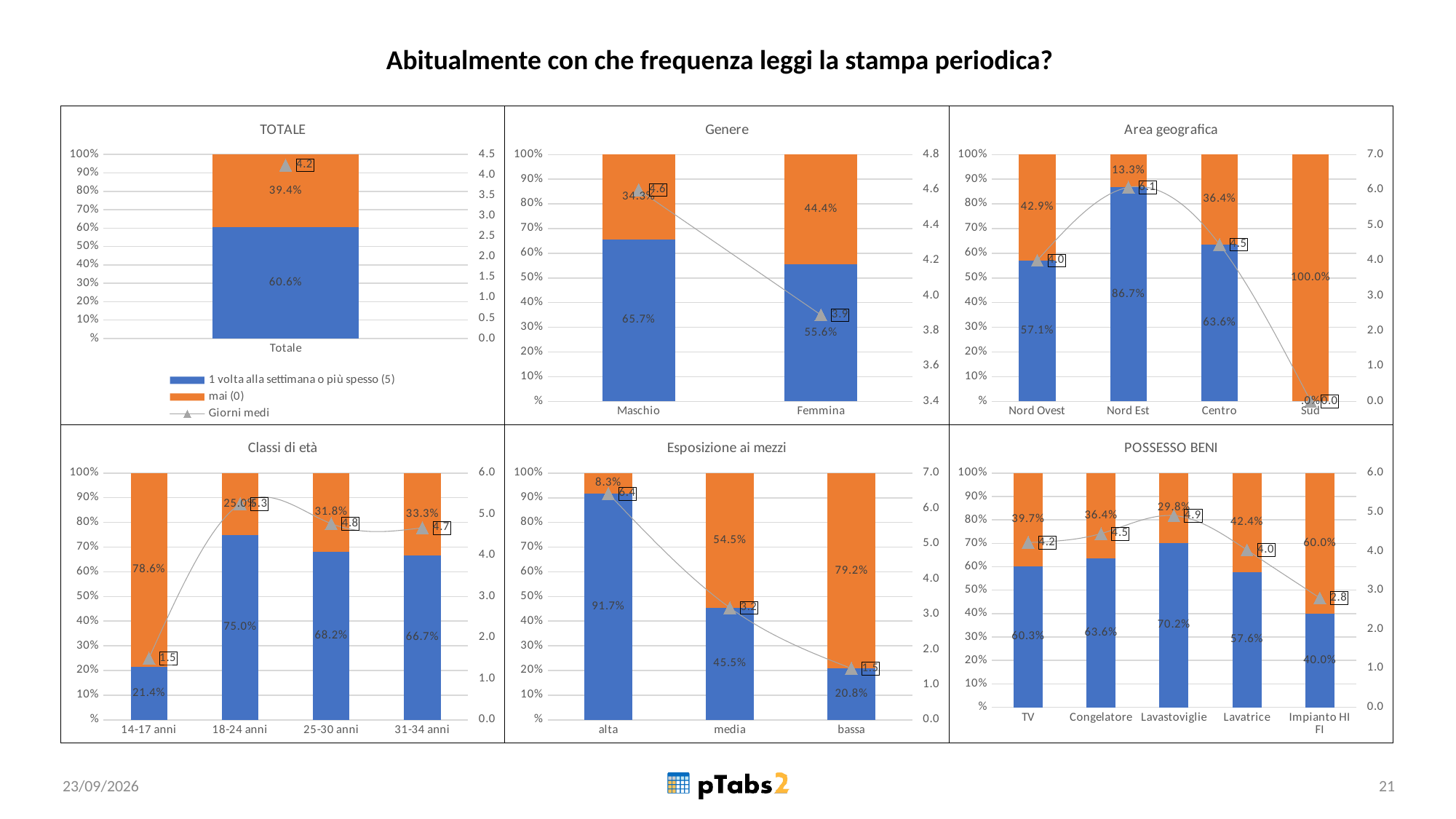
In the Classi di età chart, which age class has the lowest '1 volta alla settimana o più spesso (5)' value? 14-17 anni In the Genere chart, what is the difference between the 'mai (0)' values for Femmina and Maschio? 10.1 percentage points In the Esposizione ai mezzi chart, does the 'Giorni medi' line rise or fall from alta to bassa? fall In the POSSESSO BENI chart, what is the 'Giorni medi' value for Impianto HI FI? 2.8 How many categories are shown on the x axis of the Classi di età chart? 4 In the POSSESSO BENI chart, which is larger: the '1 volta alla settimana o più spesso (5)' value for Lavastoviglie or for Lavatrice? Lavastoviglie In the Genere chart, what is the 'Giorni medi' value for Femmina? 3.9 In the TOTALE chart, what is the value for '1 volta alla settimana o più spesso (5)'? 60.6% In the Esposizione ai mezzi chart, what is the 'mai (0)' value for media? 54.5% In the Area geografica chart, which category has the highest 'Giorni medi' value? Nord Est In the Area geografica chart, what is the 'mai (0)' value for Sud? 100.0% How many series does the legend in the TOTALE chart list? 3